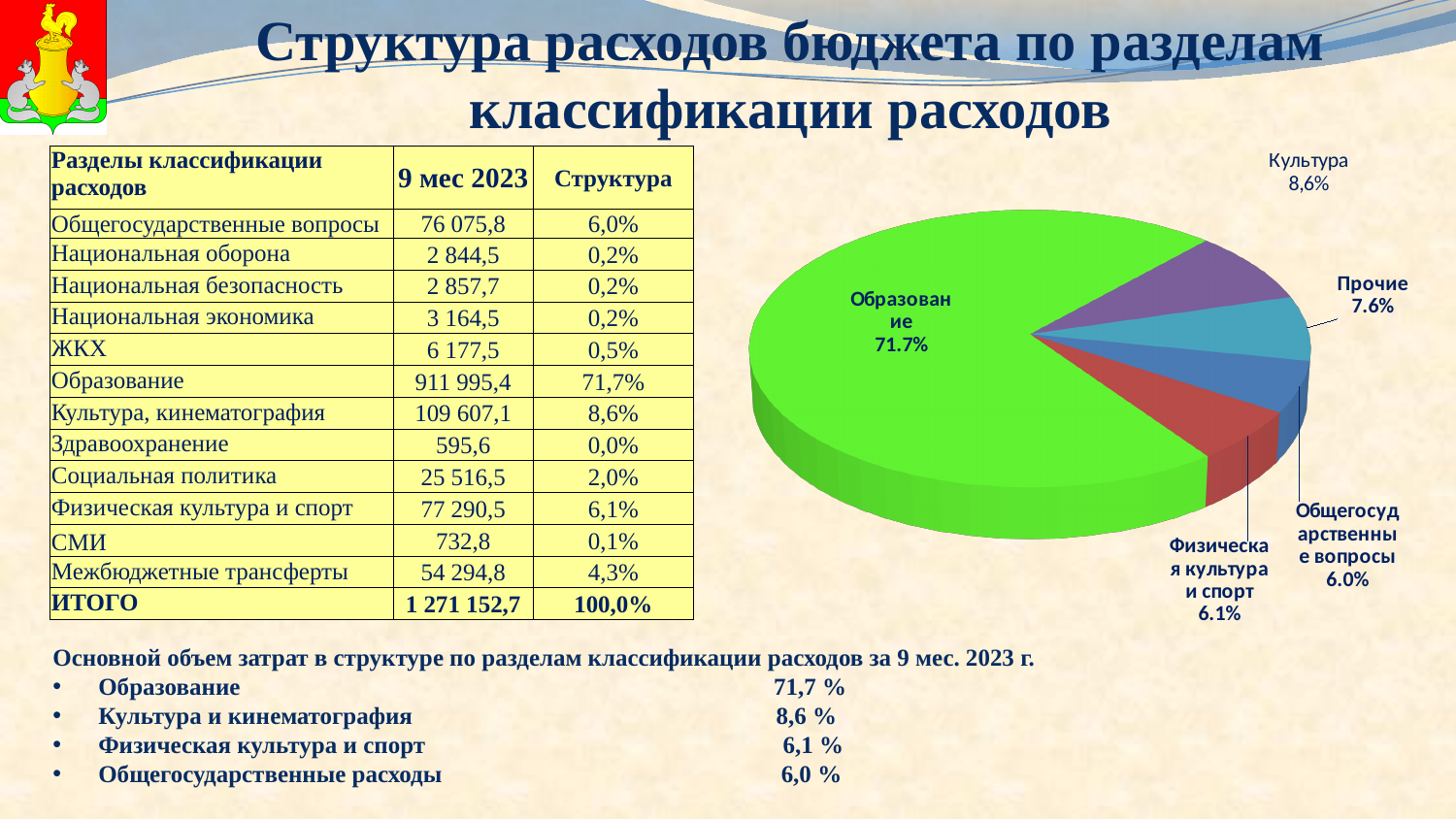
What share of the pie chart is labelled for Общегосударственные вопросы? 6.0% What share of the pie chart is labelled for Физическая культура и спорт? 6.1% Which slice is larger in the pie chart, Культура or Прочие? Культура What share of the pie chart is labelled for Культура? 8,6% What kind of chart is shown on the slide? pie chart By how many percentage points does the Образование slice exceed the Культура slice in the pie chart? 63.1 What colour is the Образование slice in the pie chart? green What share of the pie chart is labelled for Образование? 71.7% Is the share for Образование in the pie chart greater or less than 50%? greater Which slice of the pie chart is the largest? Образование How many slices does the pie chart have? 5 What share of the pie chart is labelled for Прочие? 7.6%